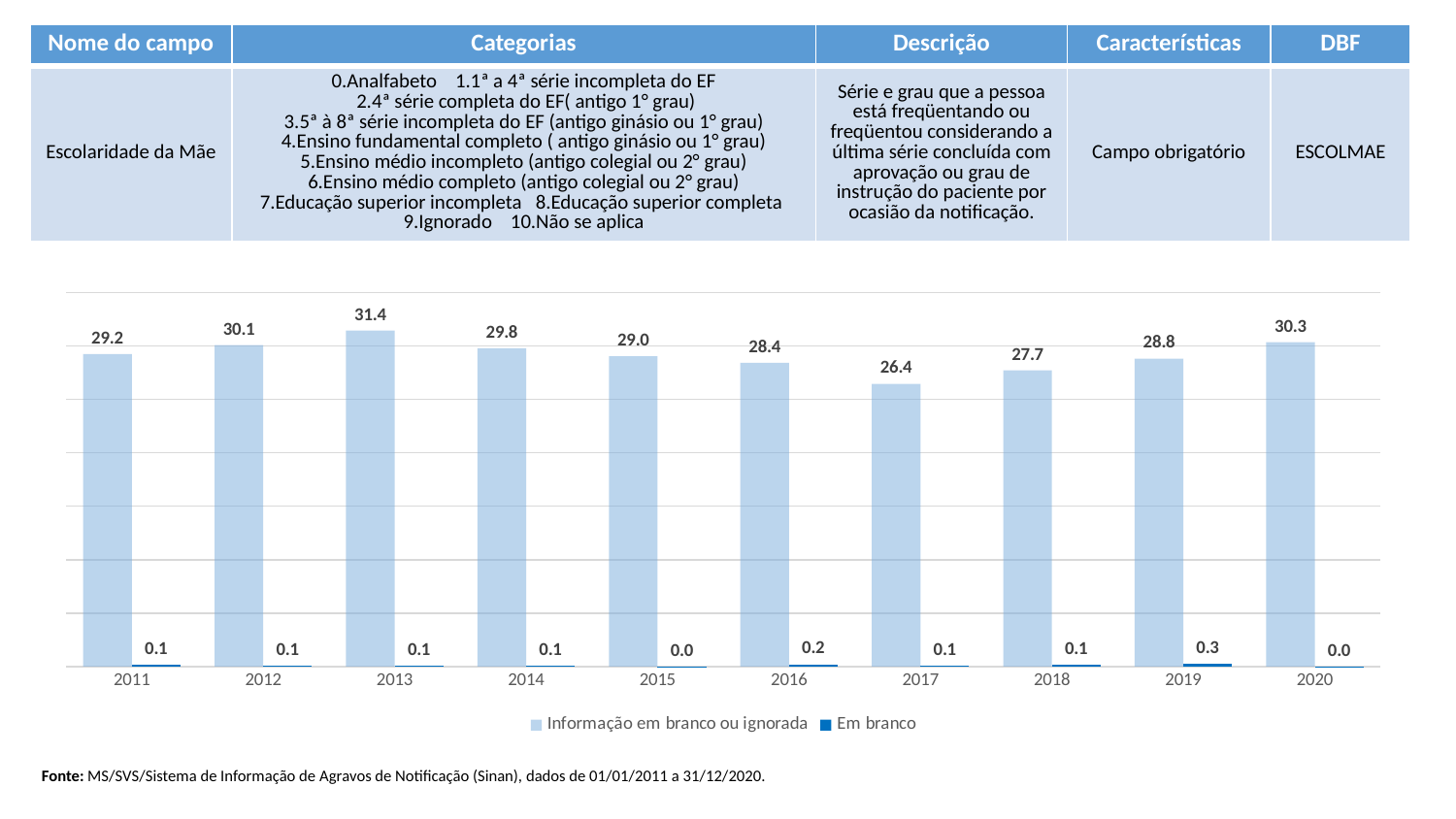
What is the value for "Em branco" in 2019? 0.3 Which is larger, the "Informação em branco ou ignorada" value for 2012 or for 2020? 2020 How many series does the chart legend list? 2 What is the value for "Informação em branco ou ignorada" in 2013? 31.4 What is the value for "Em branco" in 2016? 0.2 Does the "Informação em branco ou ignorada" series rise or fall from 2013 to 2017? Fall What kind of chart is shown on the slide? Bar chart How many years are shown on the x axis of the chart? 10 Which year has the lowest value for "Informação em branco ou ignorada"? 2017 What is the value for "Informação em branco ou ignorada" in 2017? 26.4 What is the difference between the "Informação em branco ou ignorada" values for 2013 and 2017? 5.0 Which year has the highest value for "Informação em branco ou ignorada"? 2013